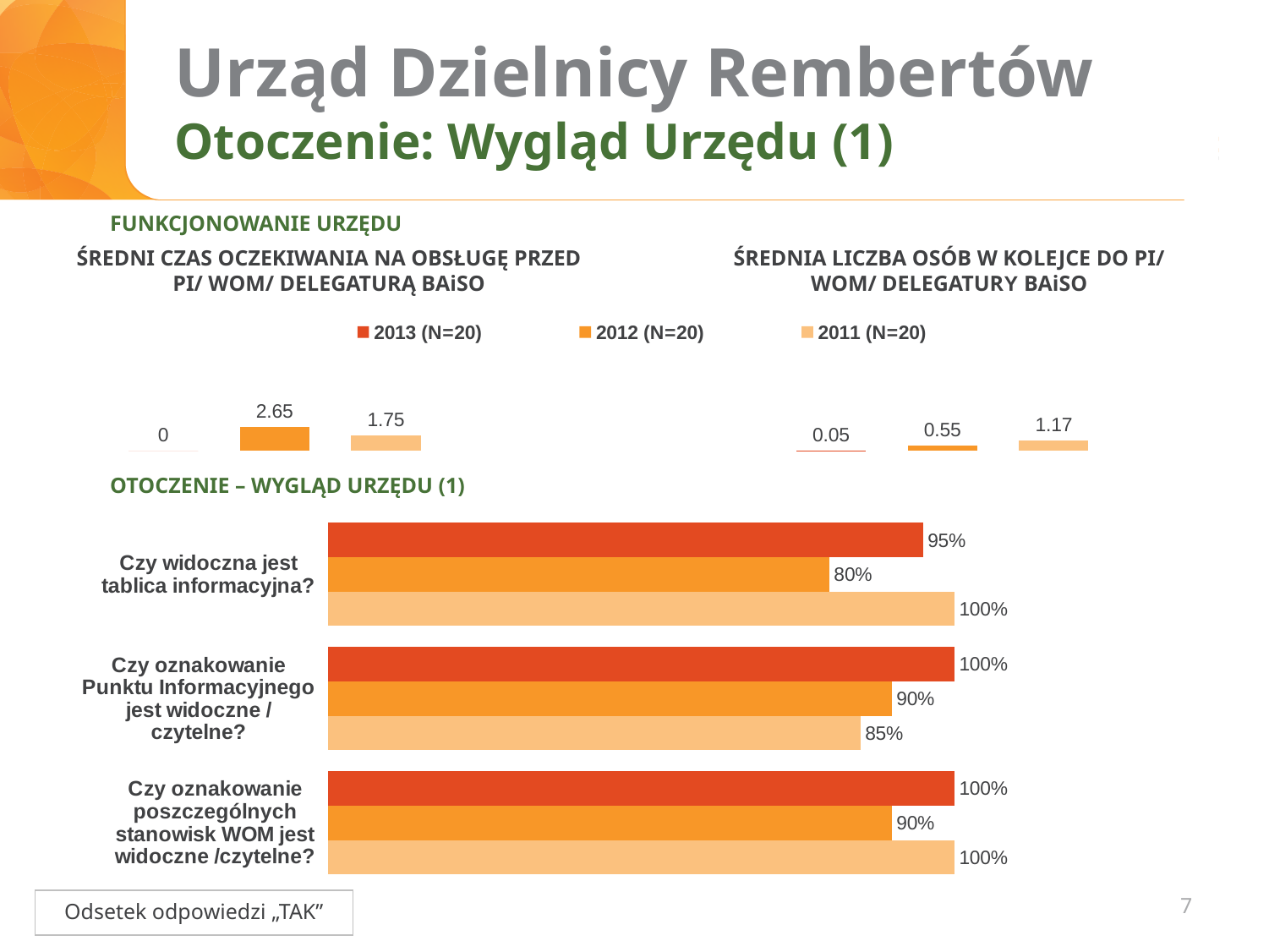
In the chart 'Otoczenie – Wygląd Urzędu (1)', what is the 2012 value for 'Czy widoczna jest tablica informacyjna?'? 80% How many series does the legend list for the charts on this slide? 3 In the chart 'Otoczenie – Wygląd Urzędu (1)', what is the 2011 value for 'Czy oznakowanie Punktu Informacyjnego jest widoczne / czytelne?'? 85% In the chart 'Średni czas oczekiwania na obsługę przed PI/ WOM/ Delegaturą BAiSO', what is the value for 2013 (N=20)? 0 In the chart 'Otoczenie – Wygląd Urzędu (1)', how many question categories are shown? 3 In the chart 'Średni czas oczekiwania na obsługę przed PI/ WOM/ Delegaturą BAiSO', which year has the highest value? 2012 (N=20) In the chart 'Średnia liczba osób w kolejce do PI/ WOM/ Delegatury BAiSO', what is the difference between the 2011 and 2012 values? 0.62 What type of chart is 'Otoczenie – Wygląd Urzędu (1)'? Bar chart In the chart 'Średnia liczba osób w kolejce do PI/ WOM/ Delegatury BAiSO', which year has the lowest value? 2013 (N=20) In the chart 'Średnia liczba osób w kolejce do PI/ WOM/ Delegatury BAiSO', what is the value for 2011 (N=20)? 1.17 In the chart 'Średni czas oczekiwania na obsługę przed PI/ WOM/ Delegaturą BAiSO', what is the value for 2012 (N=20)? 2.65 In the chart 'Otoczenie – Wygląd Urzędu (1)', what is the difference between the 2013 and 2012 values for 'Czy oznakowanie poszczególnych stanowisk WOM jest widoczne /czytelne?'? 10%